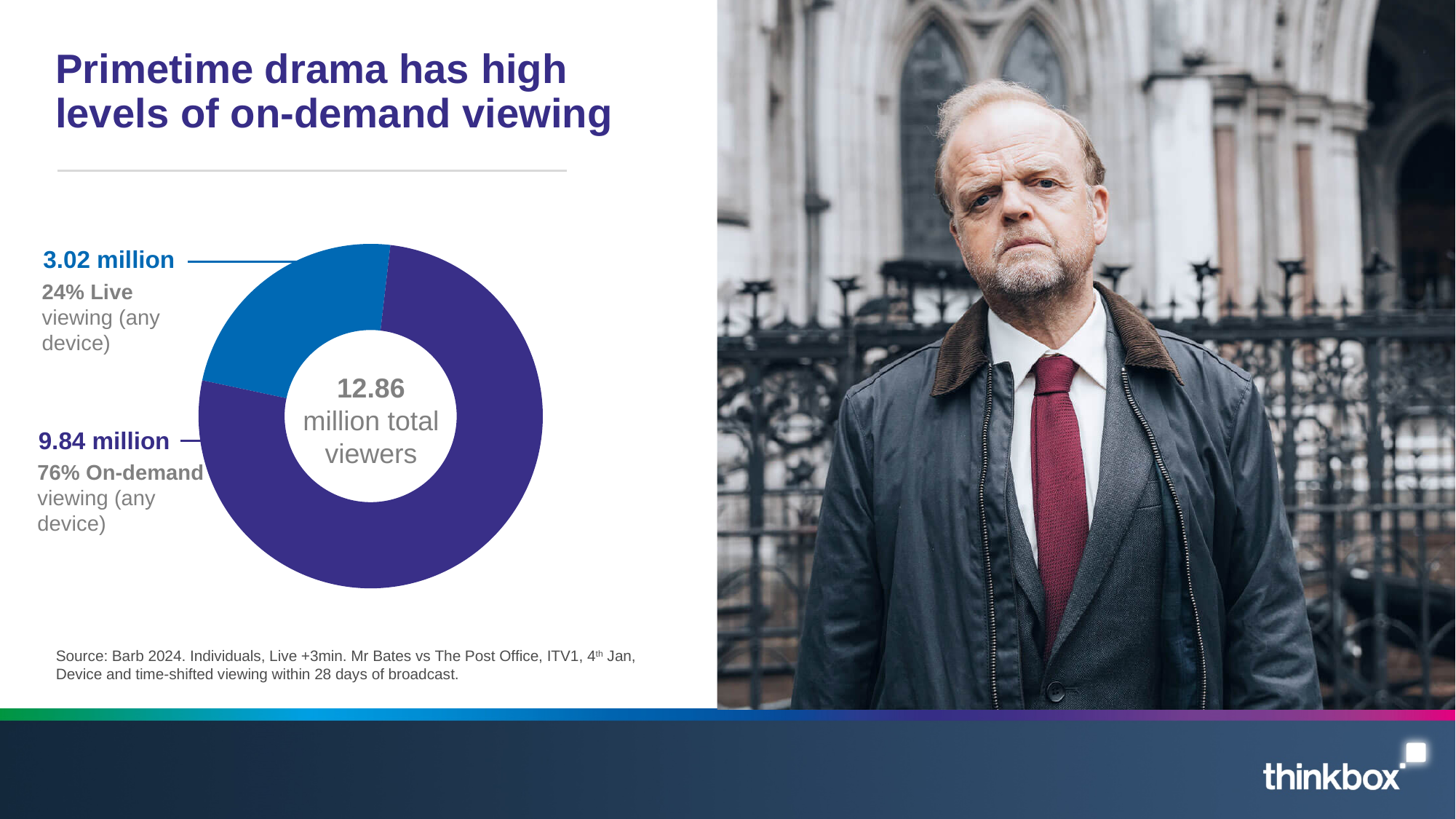
How many segments does the chart have? 2 How many viewers does the On-demand viewing (any device) segment represent? 9.84 million Which programme is the chart's data about, according to the source note? Mr Bates vs The Post Office What is the difference in viewers between On-demand viewing and Live viewing? 6.82 million What is the total number of viewers shown in the centre of the chart? 12.86 million What share of total viewers is On-demand viewing (any device)? 76% Which segment has the smallest number of viewers? Live viewing (any device) What is the title of the slide containing the chart? Primetime drama has high levels of on-demand viewing How many viewers does the Live viewing (any device) segment represent? 3.02 million What kind of chart is shown on the slide? Doughnut (pie) chart Which segment is larger, Live viewing or On-demand viewing? On-demand viewing What share of total viewers is Live viewing (any device)? 24%